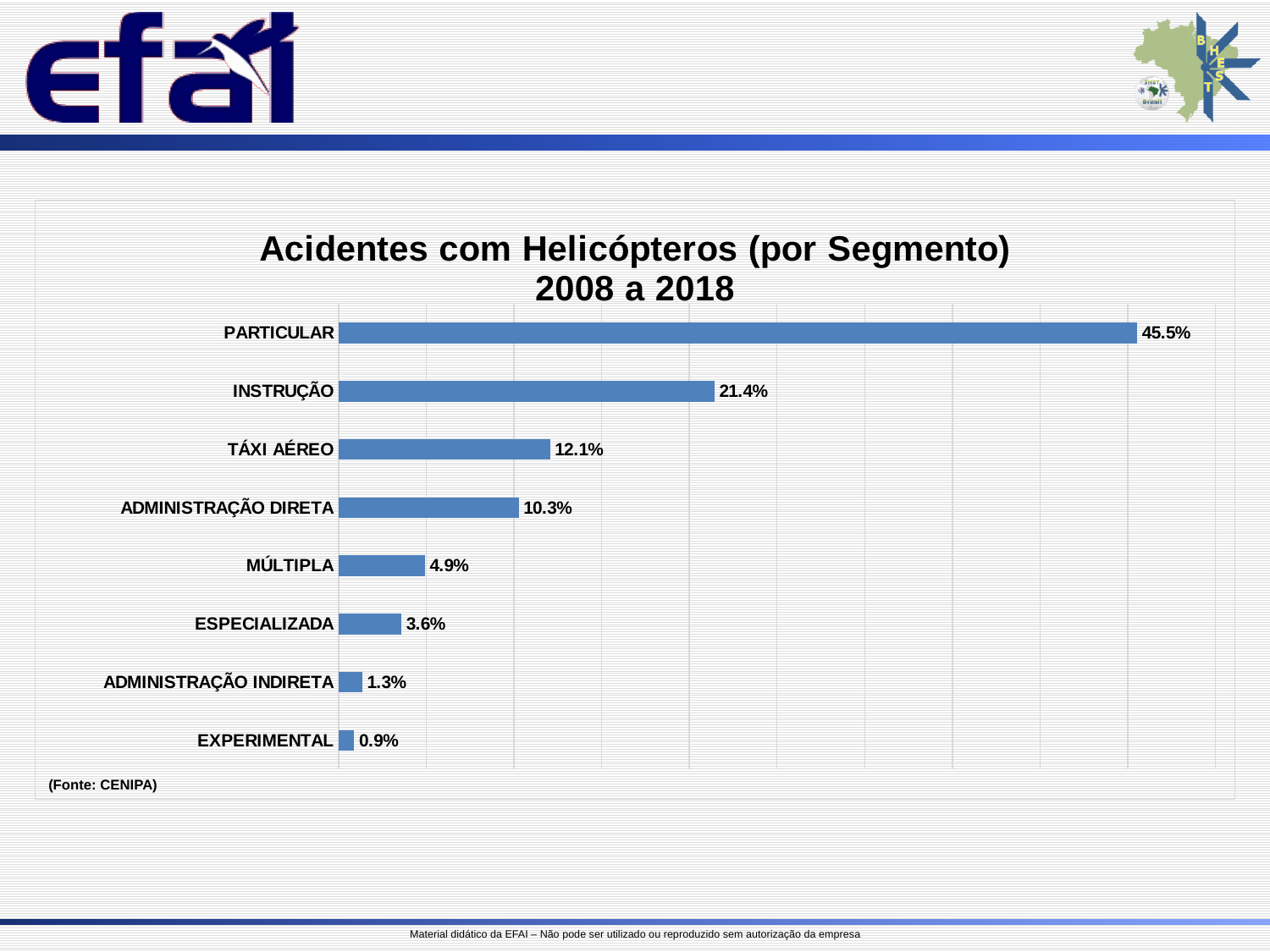
Which segment has the lowest share of helicopter accidents? EXPERIMENTAL What is the value for TÁXI AÉREO? 12.1% What is the difference between the values for PARTICULAR and INSTRUÇÃO? 24.1% Which segment has the highest share of helicopter accidents? PARTICULAR Which is larger, the value for MÚLTIPLA or the value for ESPECIALIZADA? MÚLTIPLA What is the value for PARTICULAR? 45.5% How many segments are shown in the chart? 8 What is the title of the chart? Acidentes com Helicópteros (por Segmento) 2008 a 2018 What is the difference between the values for TÁXI AÉREO and ADMINISTRAÇÃO DIRETA? 1.8% What is the value for ADMINISTRAÇÃO INDIRETA? 1.3% What kind of chart is shown on the slide? Bar chart What source is cited below the chart? CENIPA